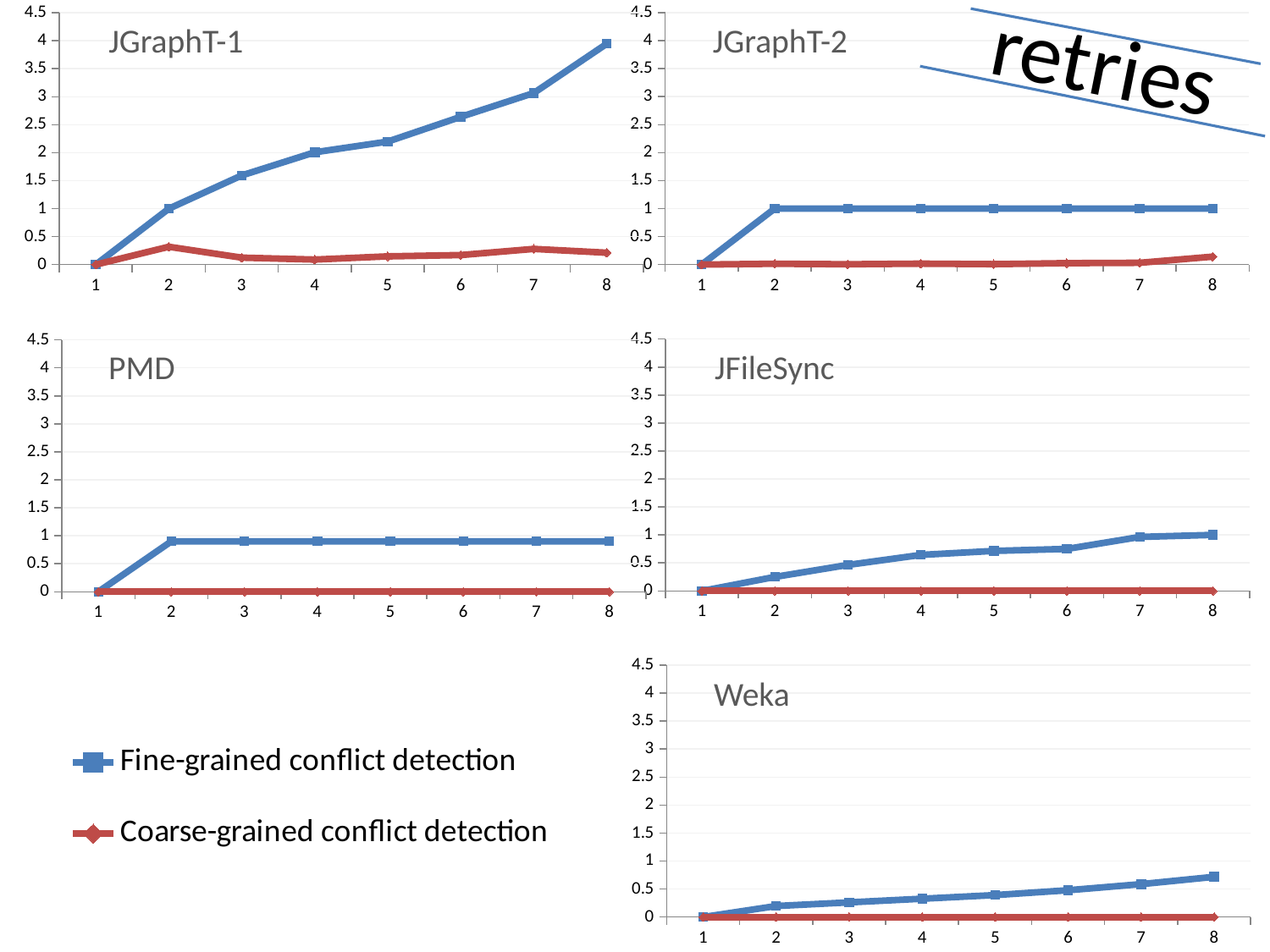
In the JFileSync chart, is the Fine-grained conflict detection value at x=2 greater or less than 0.5? less How many points are plotted along the x axis in the Weka chart for each series? 8 In the JGraphT-1 chart, at which x value is the Fine-grained conflict detection series highest? 8 In the JGraphT-1 chart, is the Fine-grained conflict detection value at x=8 greater or less than 3.5? greater In the JGraphT-1 chart, does the Fine-grained conflict detection series rise or fall from x=1 to x=8? rise How many series does the legend list? 2 In the Weka chart, which series is larger at x=8, Fine-grained conflict detection or Coarse-grained conflict detection? Fine-grained conflict detection In the PMD chart, is the Fine-grained conflict detection value at x=6 greater or less than 0.5? greater In the PMD chart, what is the Coarse-grained conflict detection value at x=4? 0 What kind of chart is the JGraphT-1 chart? line chart Which colour is used for the Coarse-grained conflict detection series? red In the JGraphT-2 chart, what is the Fine-grained conflict detection value at x=5? 1